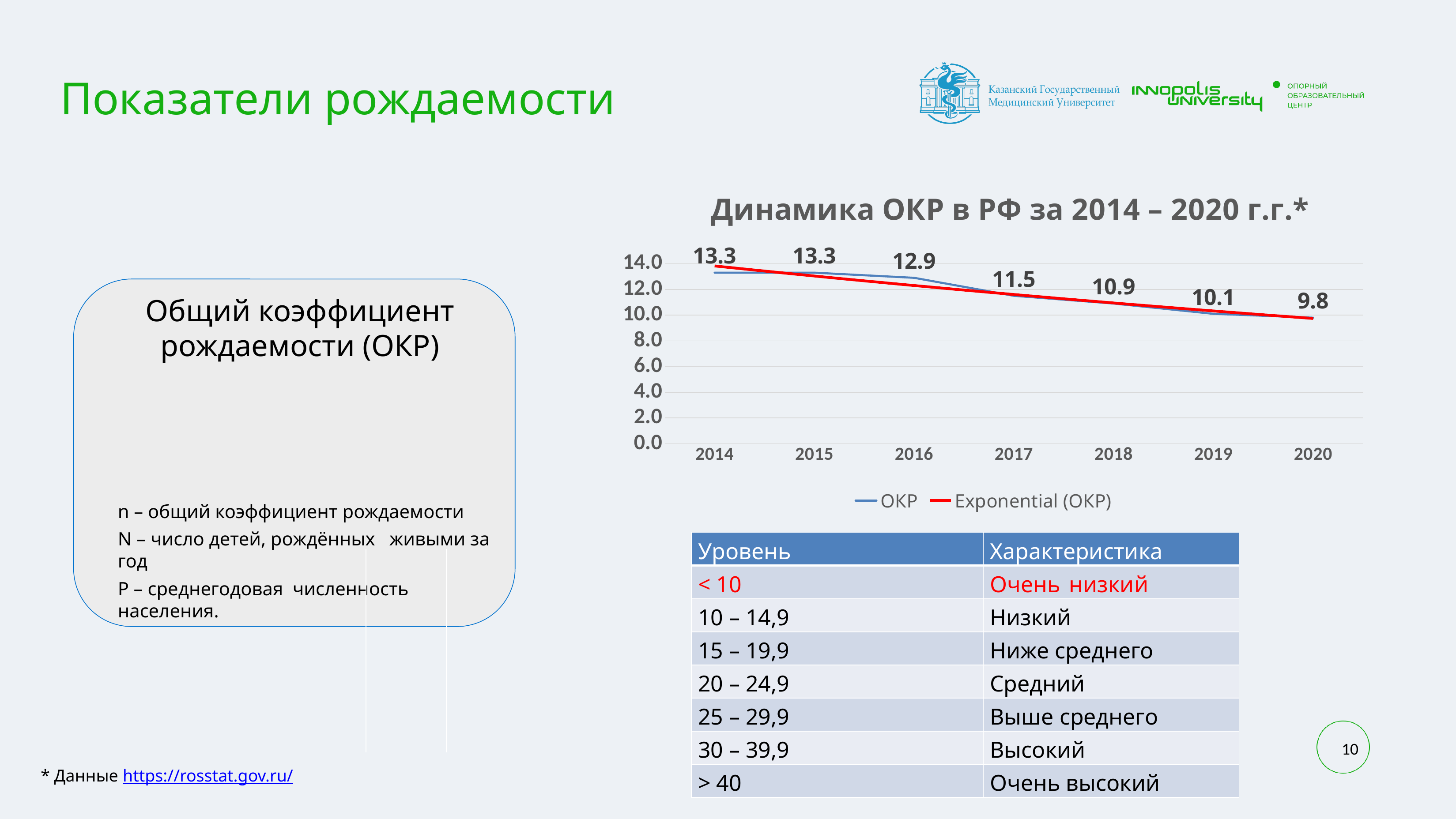
Do the ОКР values rise or fall from 2014 to 2020? fall What is the ОКР value for 2016? 12.9 How many series does the legend list? 2 What is the ОКР value for 2020? 9.8 What is the ОКР value for 2017? 11.5 What is the difference between the ОКР values for 2016 and 2017? 1.4 What kind of chart is shown? line chart Which is larger, the ОКР value for 2018 or for 2019? 2018 Is the ОКР value for 2020 greater or less than 10.0? less Which year has the lowest ОКР value? 2020 How many years are plotted on the x axis? 7 What is the difference between the ОКР values for 2014 and 2020? 3.5